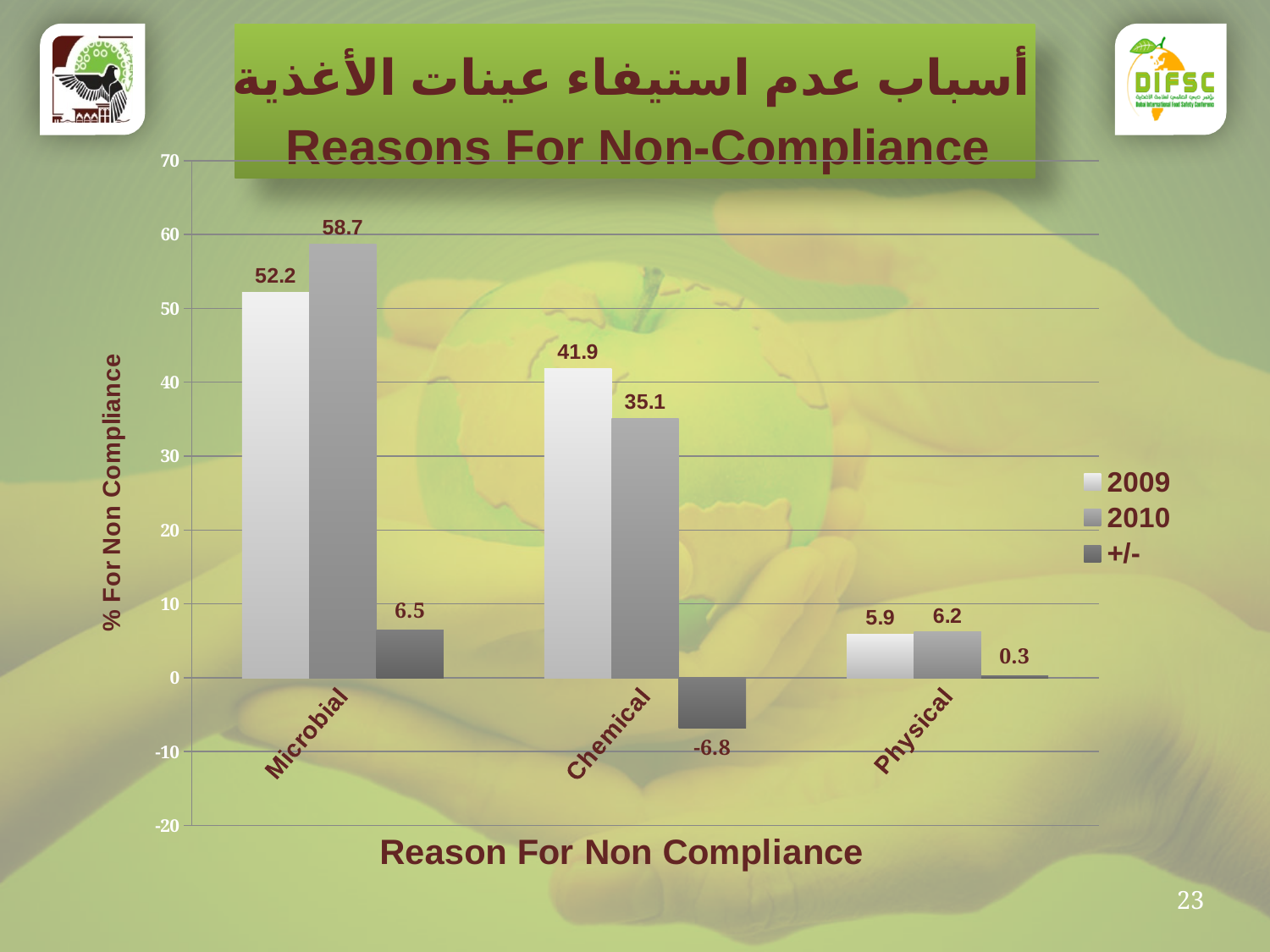
Which category has the lowest 2009 value? Physical Which is larger for Chemical, the 2009 value or the 2010 value? 2009 Which category has the highest 2010 value? Microbial How many categories are shown on the x axis? 3 What is the label of the y axis? % For Non Compliance What is the difference between the 2010 and 2009 values for Microbial? 6.5 How many series does the legend list? 3 What is the 2010 value for Physical? 6.2 What is the +/- value for Chemical? -6.8 What kind of chart is shown? Bar chart What is the 2010 value for Chemical? 35.1 What is the 2009 value for Microbial? 52.2